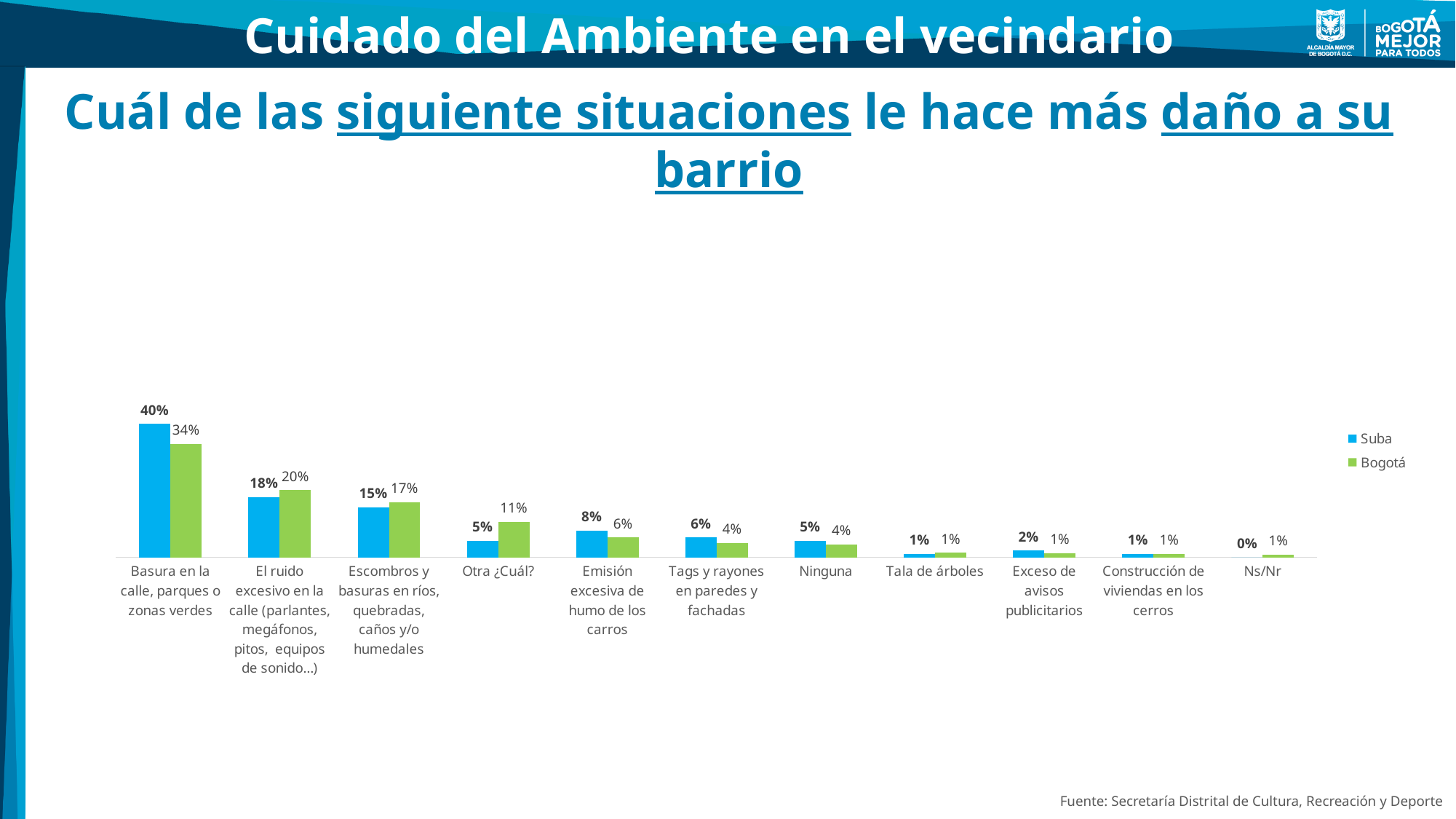
How many categories are shown on the x axis? 11 Which is larger for "Tags y rayones en paredes y fachadas": the Suba value or the Bogotá value? Suba What is the difference between the Suba and Bogotá values for "Basura en la calle, parques o zonas verdes"? 6% What is the difference between the Bogotá and Suba values for "Otra ¿Cuál?"? 6% Which category has the highest Bogotá value? Basura en la calle, parques o zonas verdes What is the Suba value for "Emisión excesiva de humo de los carros"? 8% What kind of chart is shown on the slide? Bar chart What is the Bogotá value for "Otra ¿Cuál?"? 11% Which is larger for "El ruido excesivo en la calle": the Suba value or the Bogotá value? Bogotá How many series does the legend list? 2 What is the Suba value for "Basura en la calle, parques o zonas verdes"? 40% Which category has the lowest Suba value? Ns/Nr